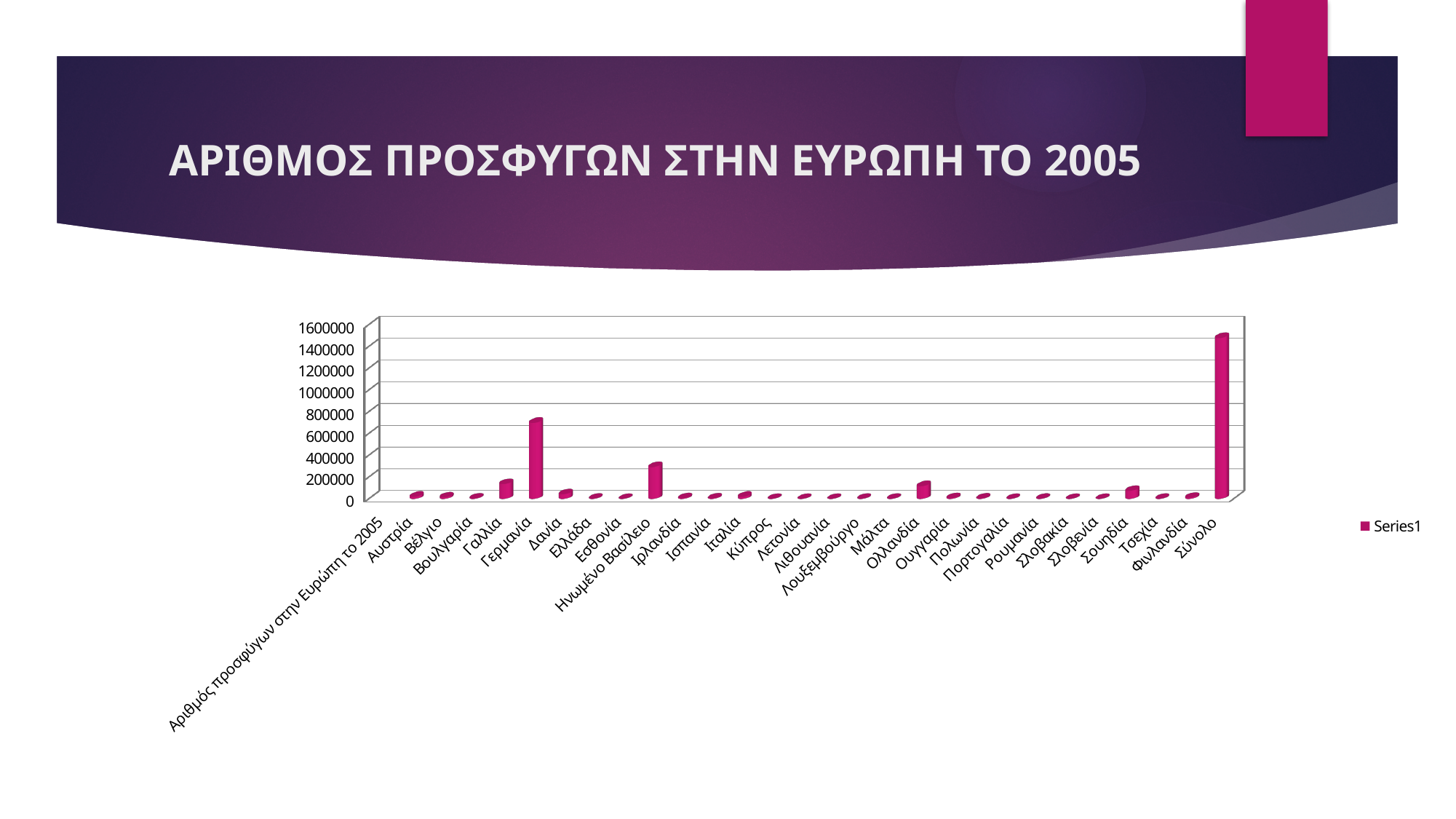
Is the value for Ηνωμένο Βασίλειο greater or less than 400000? less Which is larger, the value for Γαλλία or the value for Σουηδία? Γαλλία What is the title of the slide containing the chart? ΑΡΙΘΜΟΣ ΠΡΟΣΦΥΓΩΝ ΣΤΗΝ ΕΥΡΩΠΗ ΤΟ 2005 What is the name of the series shown in the legend? Series1 Is the value for Σύνολο greater or less than 1400000? greater How many series does the legend list? 1 Is the value for Γερμανία greater or less than 600000? greater What kind of chart is shown on the slide? bar chart Excluding Σύνολο, which country has the highest bar? Γερμανία Which is larger, the value for Γερμανία or the value for Ηνωμένο Βασίλειο? Γερμανία Which category has the highest bar in the chart? Σύνολο